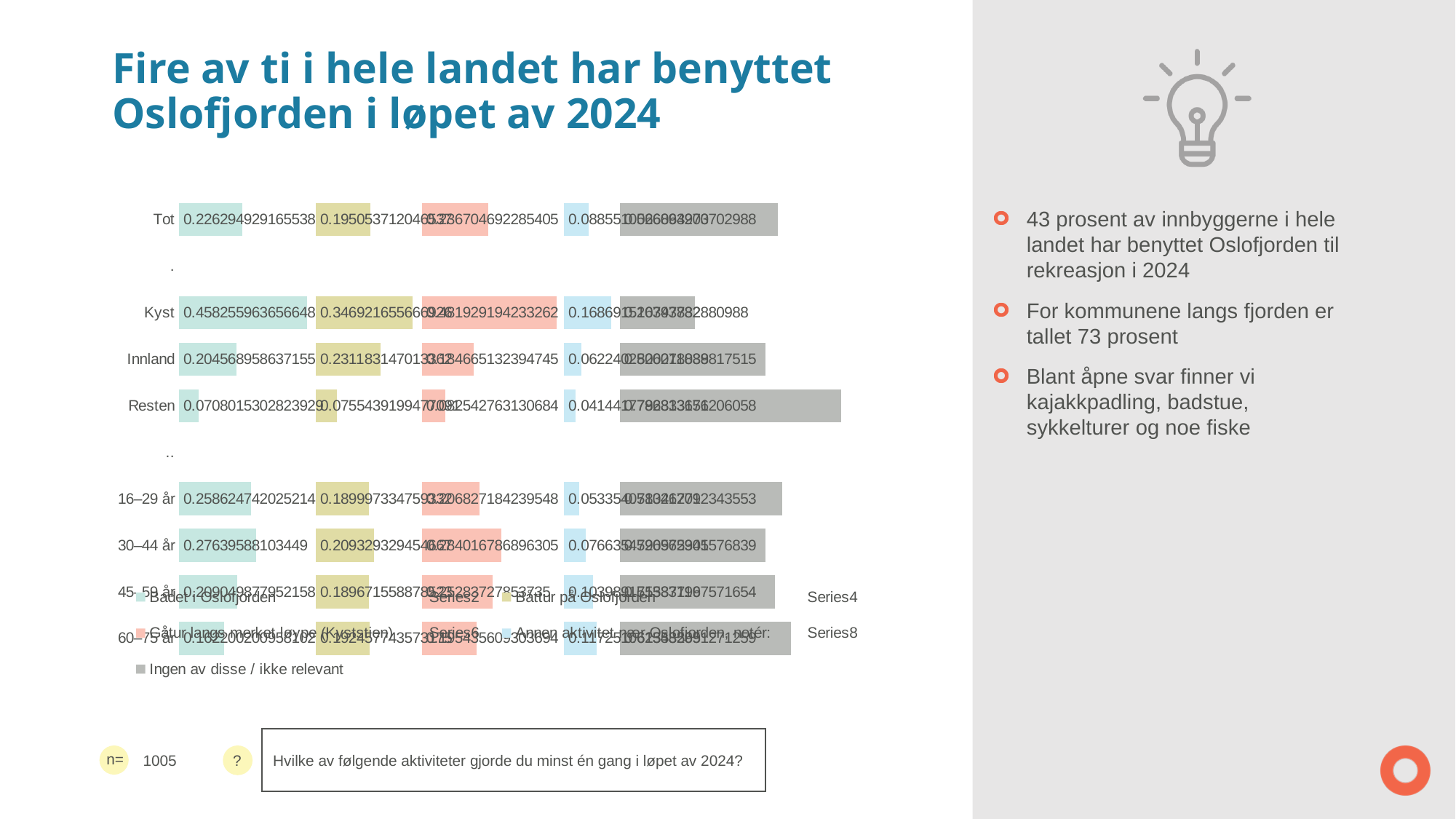
How many series does the chart legend list? 9 Among Kyst, Innland and Resten, which has the highest 'Badet i Oslofjorden' value? Kyst What is the first entry listed in the chart legend? Badet i Oslofjorden Among Tot, Kyst, Innland and Resten, which has the lowest 'Badet i Oslofjorden' value? Resten What is the value of the 'Badet i Oslofjorden' segment for Innland? 0.204568958637155 What kind of chart is shown on the slide? bar chart What is the value of the 'Badet i Oslofjorden' segment for 16–29 år? 0.258624742025214 What is the value of the 'Badet i Oslofjorden' segment for Kyst? 0.458255963656648 What is the difference between the 'Badet i Oslofjorden' values for Kyst and Innland? 0.253687005019493 What is the value of the 'Badet i Oslofjorden' segment for 30–44 år? 0.27639588103449 What is the value of the 'Badet i Oslofjorden' segment for Tot? 0.226294929165538 What is the value of the 'Badet i Oslofjorden' segment for Resten? 0.0708015302823929